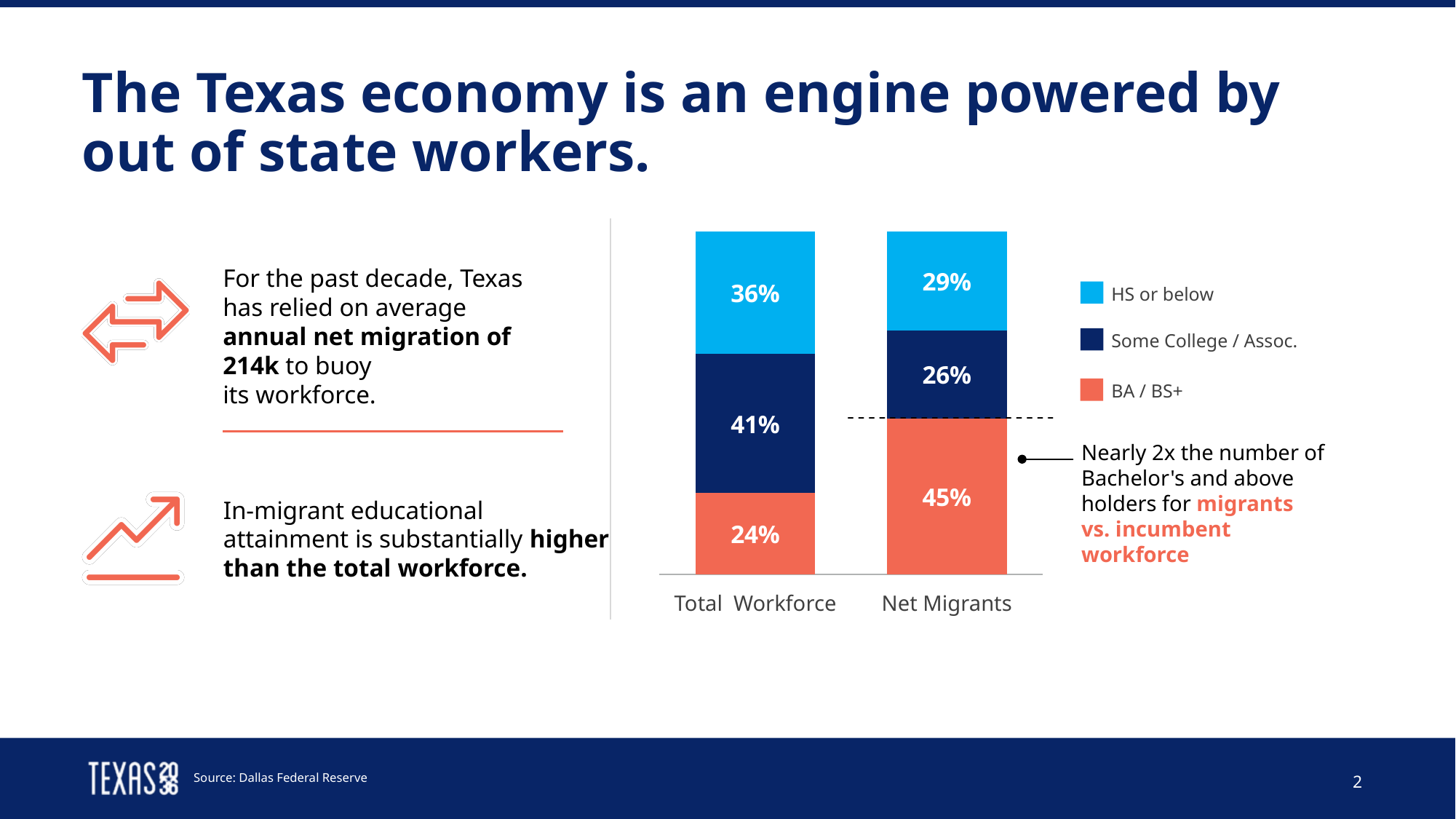
What kind of chart is shown on the slide? Stacked bar chart What is the BA / BS+ share for Total Workforce? 24% What is the HS or below share for Net Migrants? 29% What is the difference between the BA / BS+ share for Net Migrants and for Total Workforce? 21% What is the Some College / Assoc. share for Total Workforce? 41% How many series does the legend list? 3 Which category has the higher BA / BS+ share, Total Workforce or Net Migrants? Net Migrants How many categories are shown on the x axis? 2 What is the difference between the Some College / Assoc. share for Total Workforce and for Net Migrants? 15% What is the BA / BS+ share for Net Migrants? 45% Which legend entry is shown in the light blue colour? HS or below Which category has the higher HS or below share, Total Workforce or Net Migrants? Total Workforce